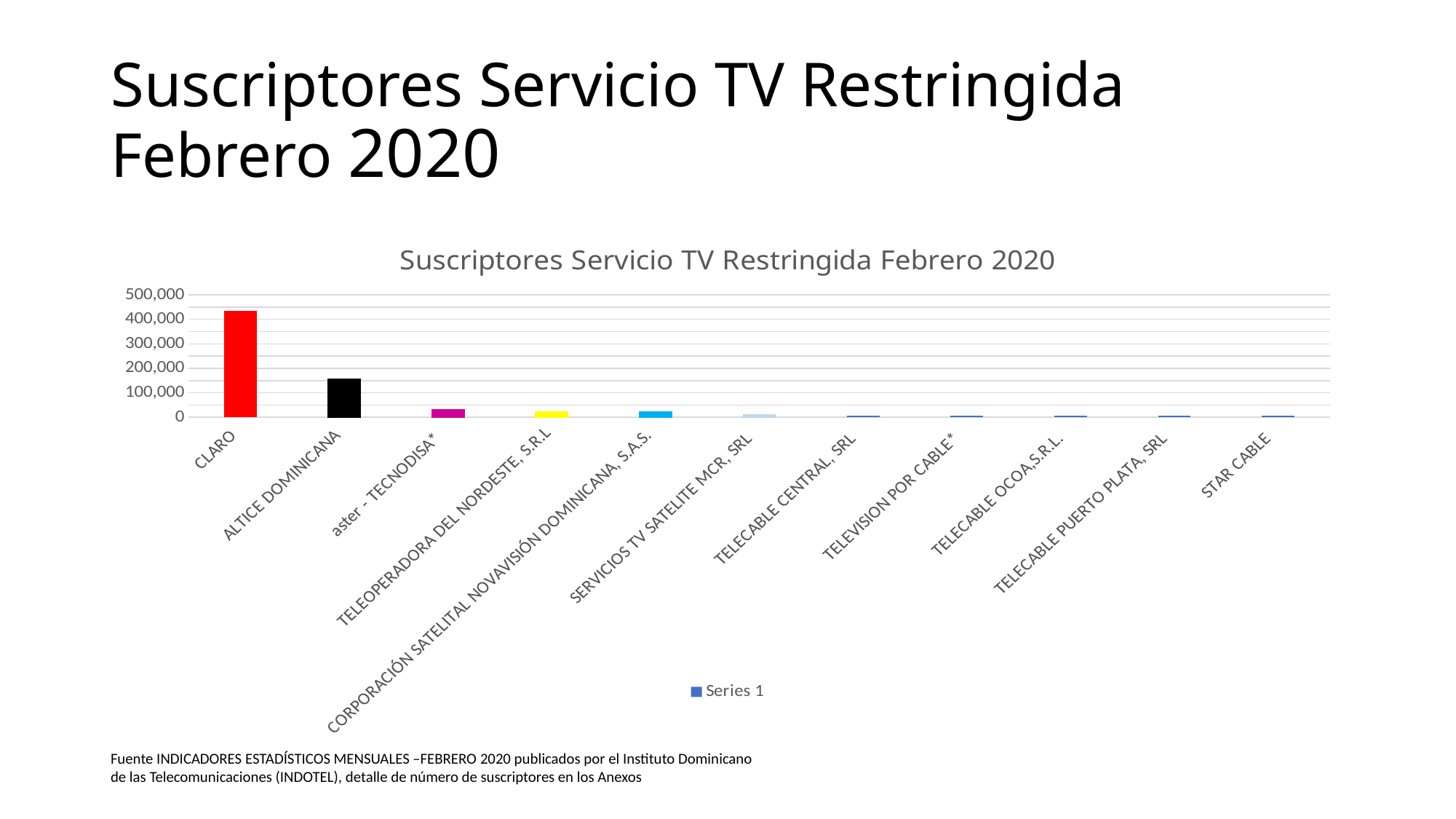
Which has more subscribers, ALTICE DOMINICANA or aster - TECNODISA*? ALTICE DOMINICANA Which company has the highest number of subscribers in the chart? CLARO What kind of chart is shown on the slide? bar chart Is the value for ALTICE DOMINICANA greater or less than 200,000? less How many series does the chart legend list? 1 Is the value for aster - TECNODISA* greater or less than 100,000? less What is the name of the series shown in the chart legend? Series 1 How many companies (categories) are plotted on the x axis of the chart? 11 Is the value for CLARO greater or less than 400,000? greater Which has more subscribers, CLARO or ALTICE DOMINICANA? CLARO Do the bar values generally rise or fall moving from left to right along the x axis? fall